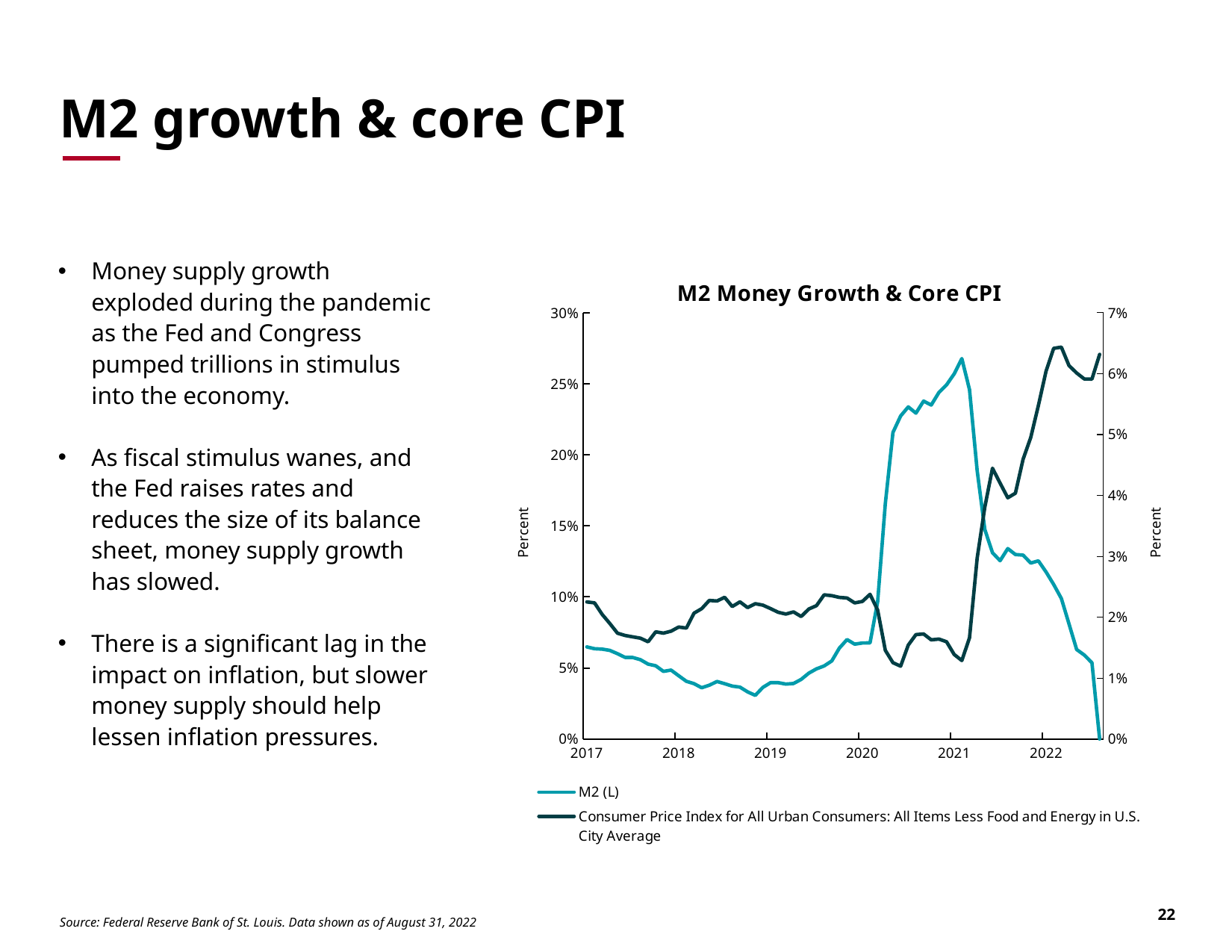
Does the Consumer Price Index line rise or fall from the start of 2021 to the start of 2022? rise Does the M2 (L) line rise or fall from 2021 to 2022? fall Is the peak value of the Consumer Price Index line in 2022 greater or less than 6% on the right axis? greater Is the value of the Consumer Price Index line during 2018 greater or less than 3% on the right axis? less Is the value of the M2 (L) line at the start of 2017 greater or less than 10%? less What kind of chart is shown on the slide? line chart Which series is plotted against the left axis, according to the legend? M2 (L) In which year shown on the x axis does the M2 (L) line reach its highest point? 2021 How many series does the chart's legend list? 2 What is the title of the chart? M2 Money Growth & Core CPI